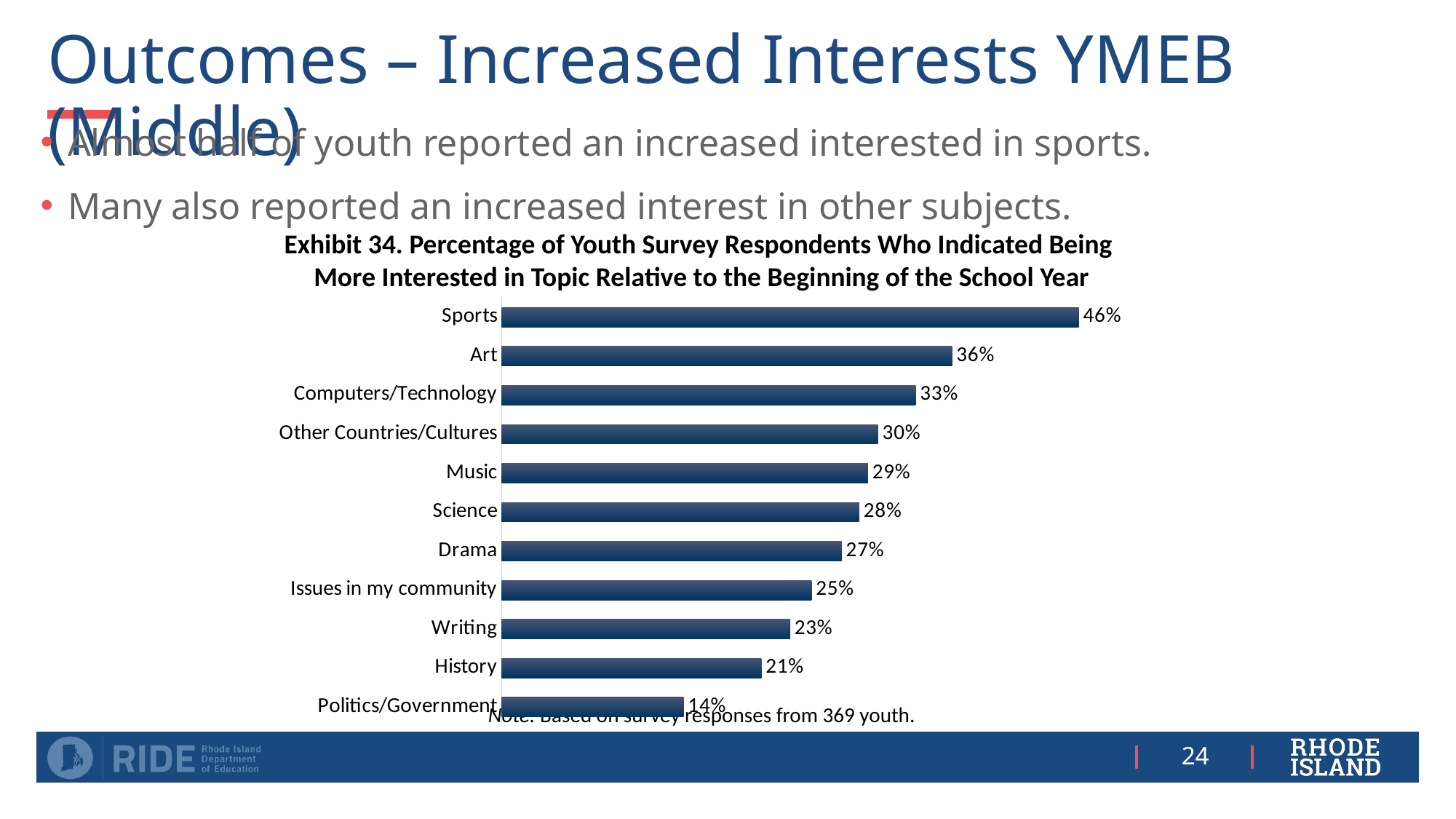
Which has a higher value, Music or Drama? Music What percentage of respondents indicated being more interested in Computers/Technology? 33% Which has a higher value, Other Countries/Cultures or Issues in my community? Other Countries/Cultures What is the difference in percentage points between History and Politics/Government? 7 What percentage of youth survey respondents indicated being more interested in Sports? 46% What is the difference in percentage points between Sports and Art? 10 Which topic has the highest percentage of respondents indicating increased interest? Sports What kind of chart is shown on the slide? Bar chart How many topics are shown in the chart? 11 What is the value shown for Writing? 23% According to the note below the chart, how many youth provided survey responses? 369 Which topic has the lowest percentage of respondents indicating increased interest? Politics/Government